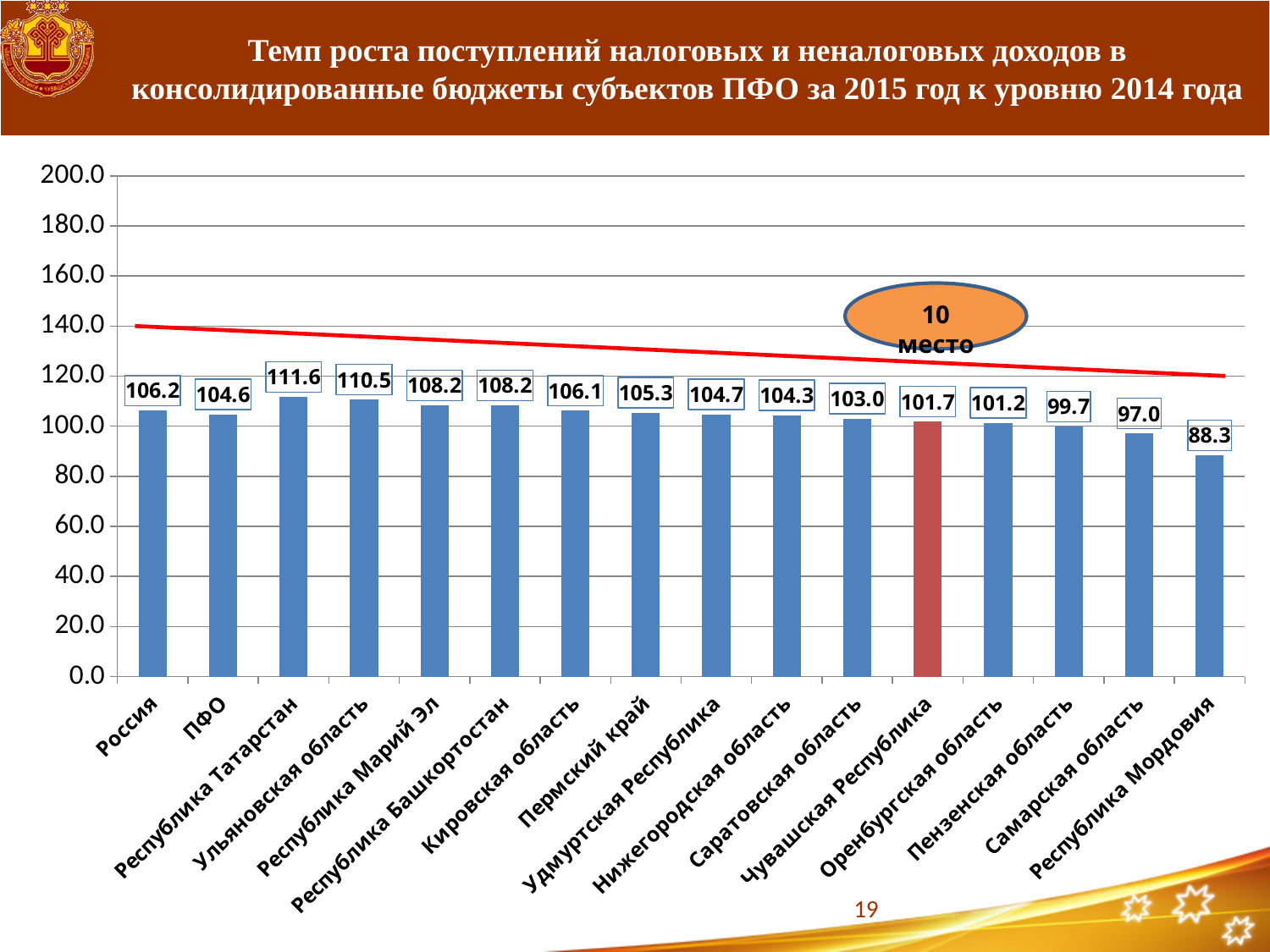
What is the difference between the values for Россия and Чувашская Республика? 4.5 How many categories are shown on the x axis? 16 Which is larger, the value for Ульяновская область or the value for Самарская область? Ульяновская область Which category has the lowest value? Республика Мордовия Which bar is coloured differently (red) from the others? Чувашская Республика What is the value for Республика Мордовия? 88.3 What is the value for Республика Татарстан? 111.6 Which category has the highest value? Республика Татарстан What is the value for ПФО? 104.6 What kind of chart is shown on the slide? bar chart Is the value for Пензенская область greater or less than 100.0? less What is the value for Чувашская Республика? 101.7